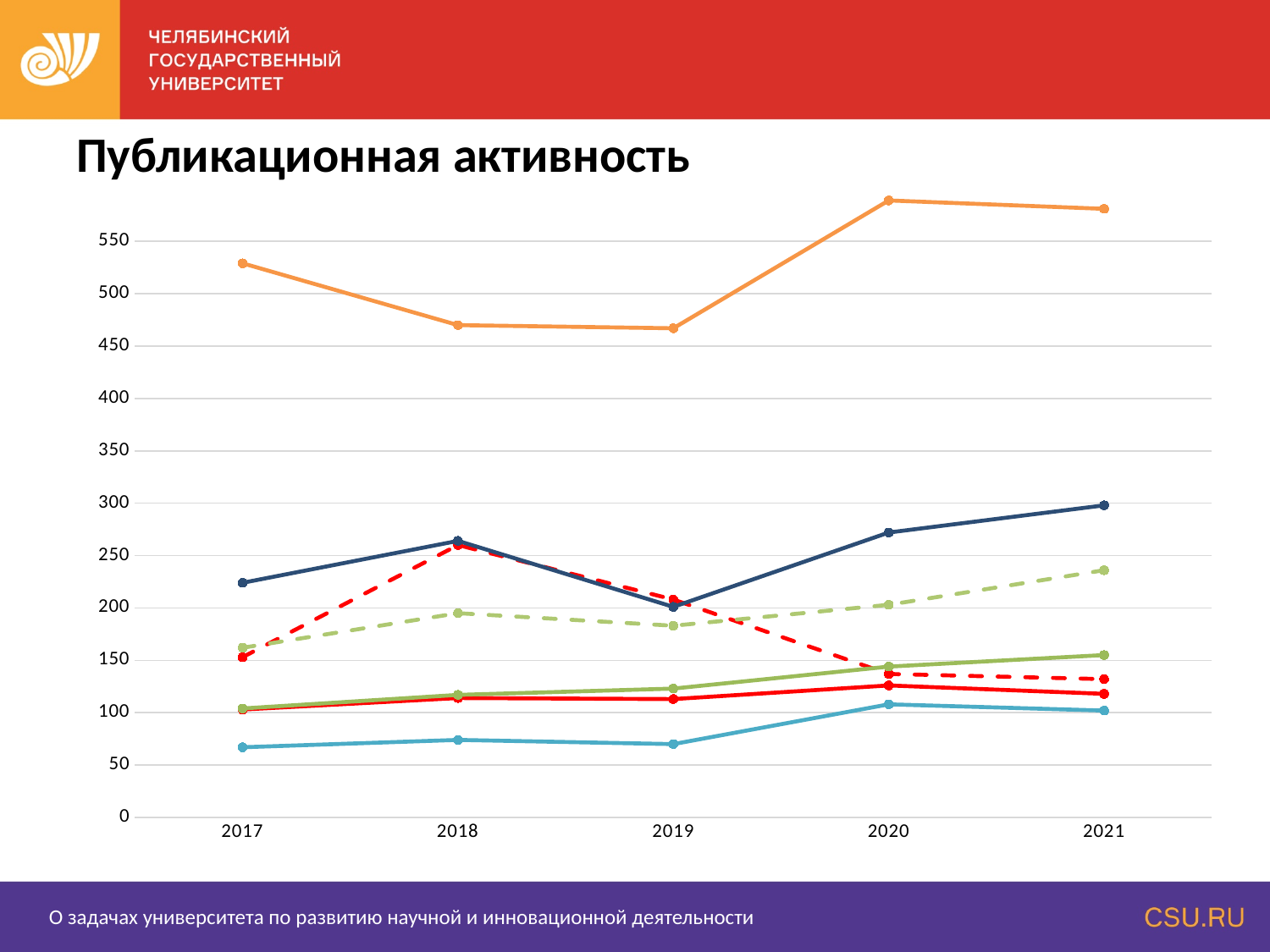
In which year does the dark blue line reach its highest value? 2021 Is the value of the light green dashed line in 2021 greater or less than 200? greater What is the title of the chart? Публикационная активность In 2021, which line is higher: the dark blue solid line or the red dashed line? the dark blue solid line Which is larger for the orange line: the value in 2017 or the value in 2018? 2017 What kind of chart is shown on the slide? line chart Does the solid green line rise or fall from 2017 to 2021? rises Is the value of the dark blue line in 2021 greater or less than 250? greater How many years are shown on the x axis of the chart? 5 Is the value of the orange line in 2020 greater or less than 550? greater How many lines are plotted on the chart? 7